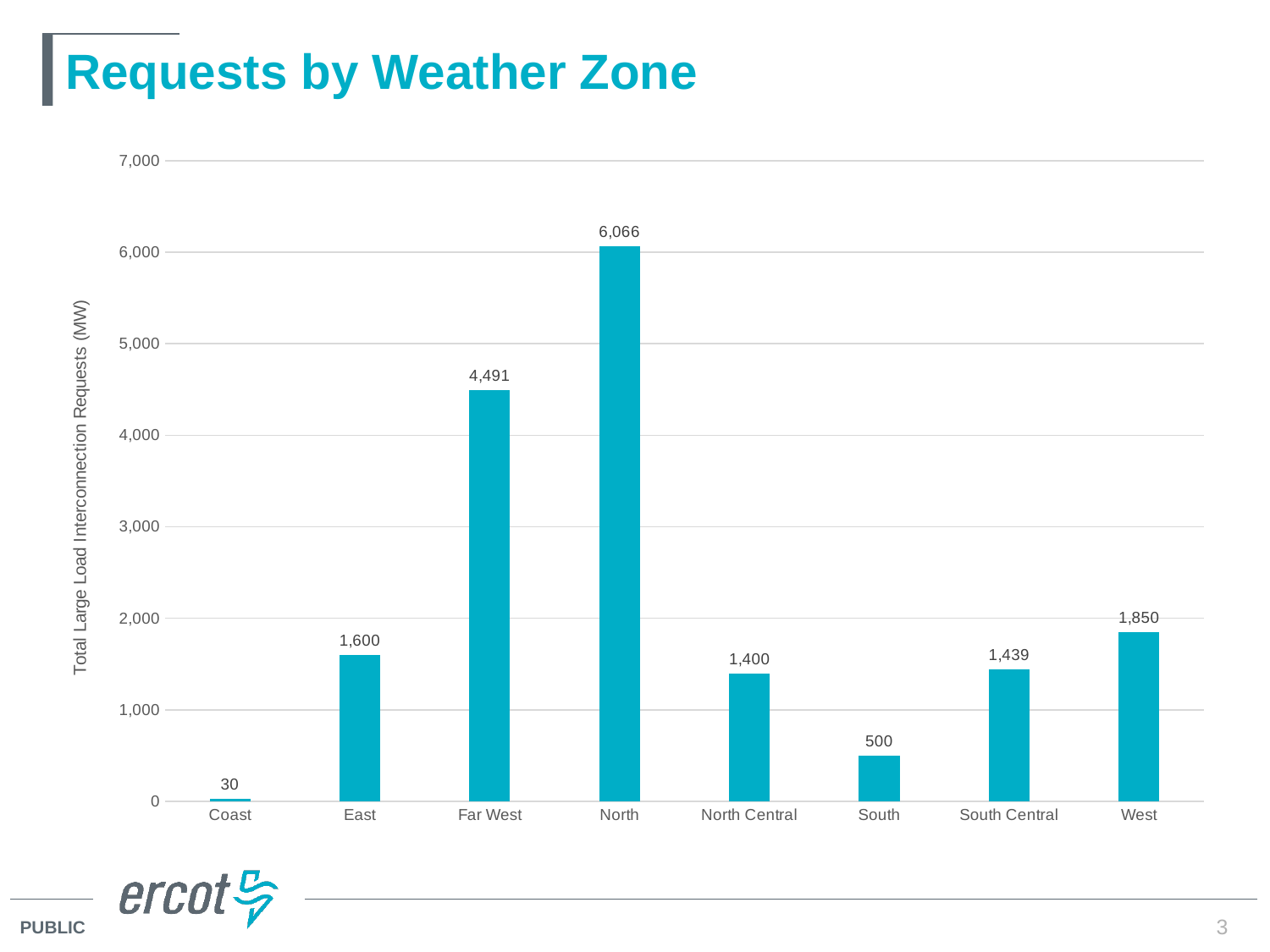
How many weather zones are shown on the x axis? 8 What is the value for South Central? 1,439 What is the value for Far West? 4,491 What is the difference between the values for West and East? 250 What kind of chart is shown on the slide? Bar chart Which weather zone has the lowest value? Coast What is the value for North? 6,066 Which is larger, the value for East or the value for North Central? East What is the value for Coast? 30 What is the y-axis label of the chart? Total Large Load Interconnection Requests (MW) Which weather zone has the highest value? North What is the difference between the values for North and Far West? 1,575